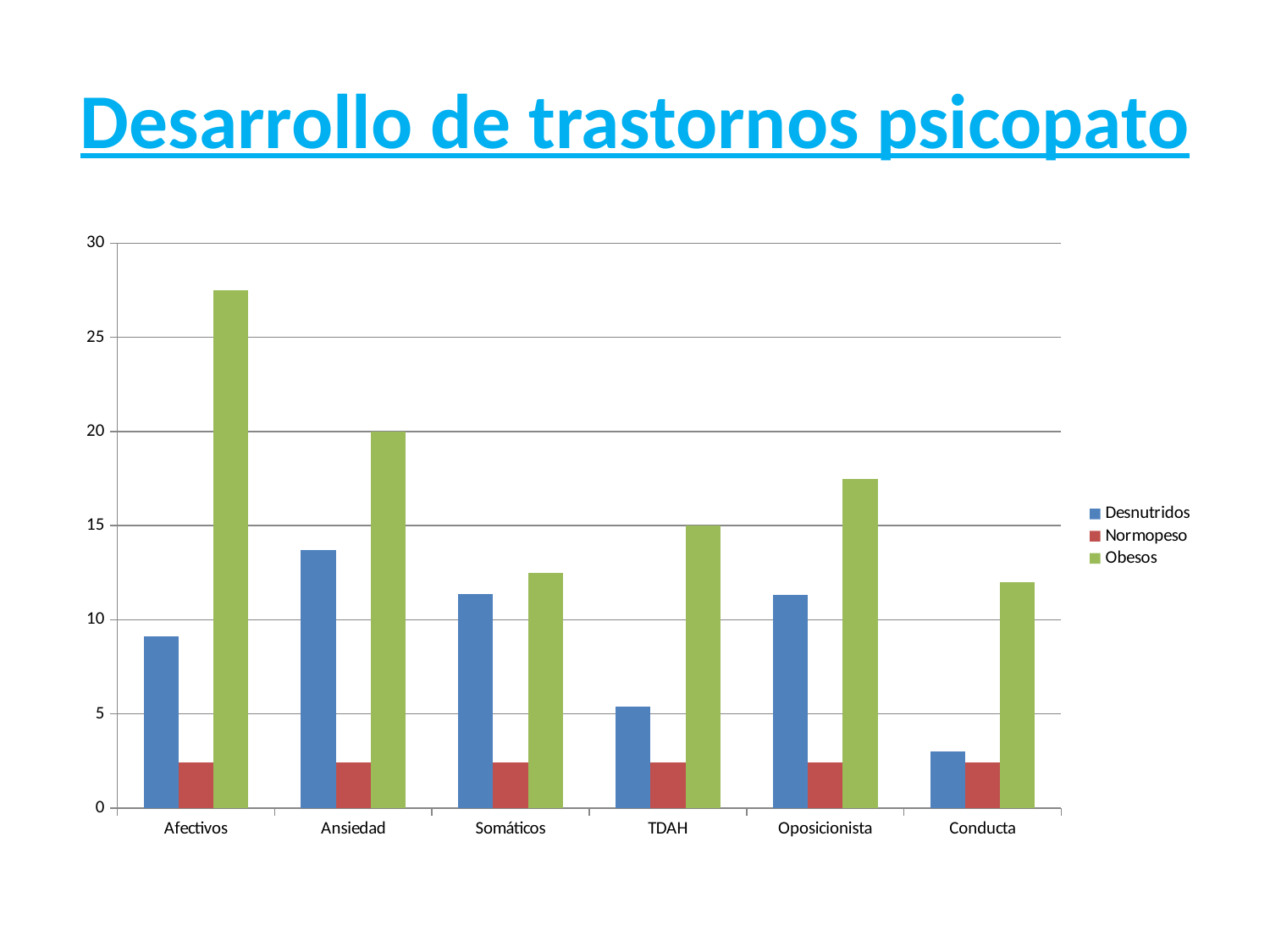
Is the value for Obesos in the Afectivos category greater or less than 25? greater Which is larger in the Ansiedad category, Desnutridos or Obesos? Obesos Is the value for Desnutridos in the TDAH category greater or less than 10? less How many categories are shown on the x axis? 6 In which category is the Obesos value lowest? Conducta In which category is the Obesos value highest? Afectivos How many series does the legend list? 3 Which series is shown in green in the legend? Obesos What is the value for Obesos in the Ansiedad category? 20 In which category is the Desnutridos value lowest? Conducta What is the value for Obesos in the TDAH category? 15 What kind of chart is shown on the slide? bar chart